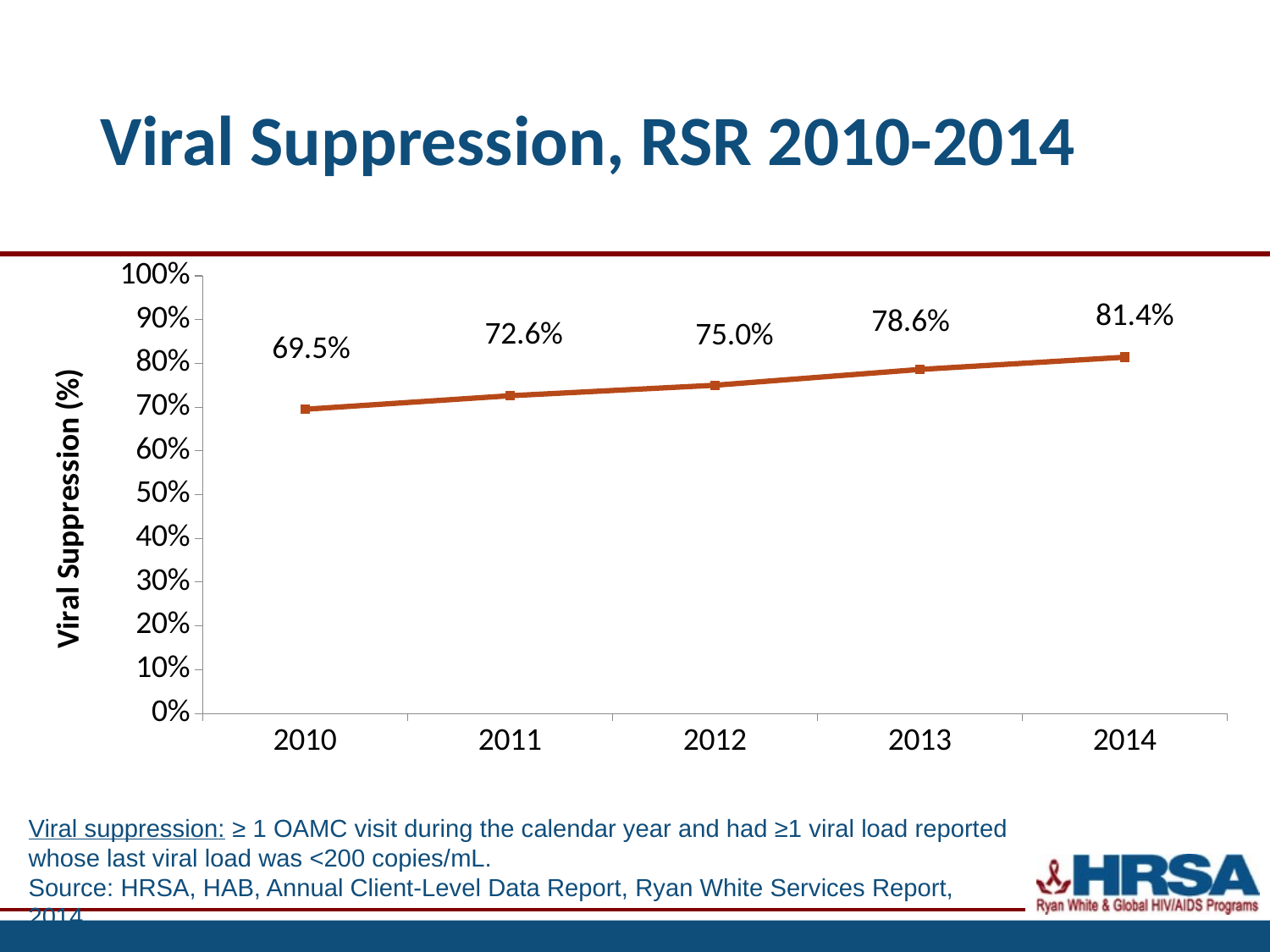
Which year has the lowest viral suppression percentage? 2010 What is the viral suppression percentage for 2014? 81.4% What is the viral suppression percentage for 2010? 69.5% What is the difference in viral suppression between 2013 and 2011? 6.0% Which year has a higher viral suppression percentage, 2011 or 2013? 2013 How many years are plotted on the chart? 5 What is the viral suppression percentage for 2012? 75.0% What is the difference in viral suppression between 2014 and 2010? 11.9% Is the viral suppression value for 2014 greater or less than 80%? greater Which year has the highest viral suppression percentage? 2014 What kind of chart is shown on the slide? Line chart Do the viral suppression values rise or fall from 2010 to 2014? Rise